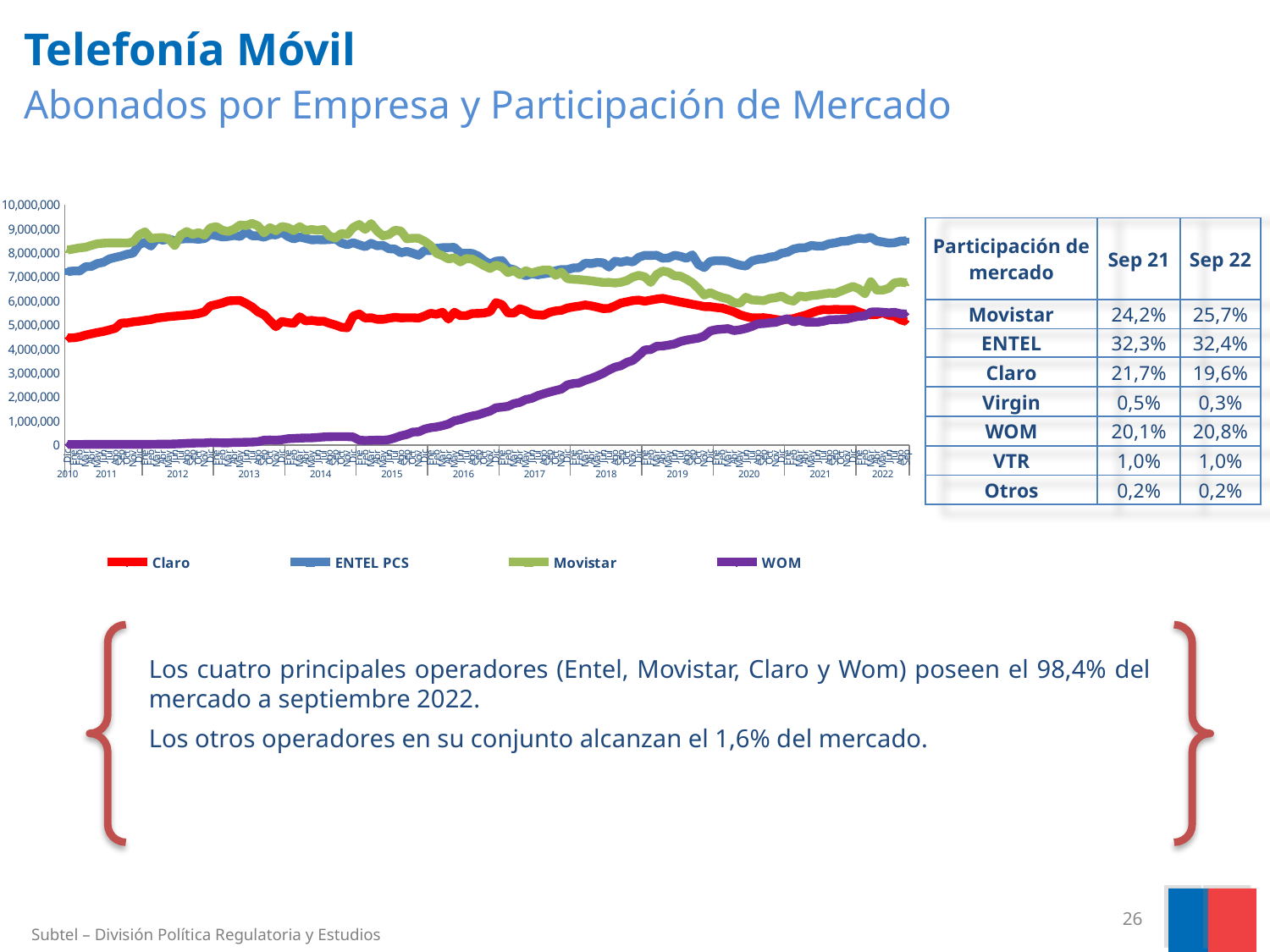
What colour is the WOM line in the chart? purple Does the Movistar line rise or fall from 2013 to 2022? fall Which series has the highest value at the end of 2022? ENTEL PCS Is the value for ENTEL PCS at the end of 2022 greater or less than 8,000,000? greater Which series has the lowest value in 2010? WOM Is the value for Claro at the start of 2010 greater or less than 5,000,000? less Does the WOM line rise or fall from 2015 to 2022? rise Is the value for WOM in 2010 greater or less than 1,000,000? less What kind of chart is shown on the slide? line chart At the end of 2022, which is larger, ENTEL PCS or Movistar? ENTEL PCS How many series does the chart legend list? 4